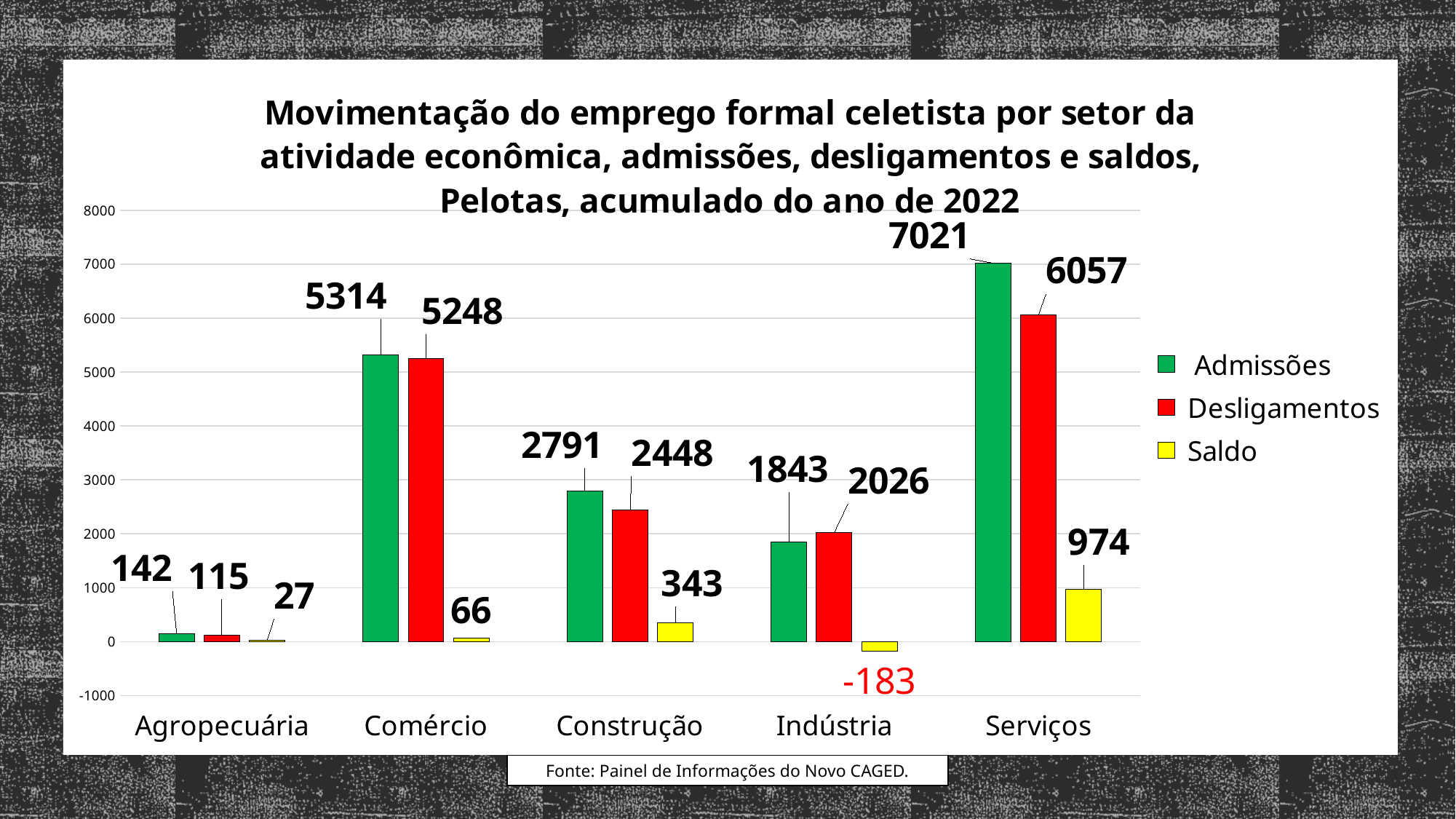
What colour represents the Saldo series in the legend? Yellow Which sector has the lowest Desligamentos value? Agropecuária What is the difference between Admissões and Desligamentos for Construção? 343 What kind of chart is shown on the slide? Bar chart What is the value of Admissões for Serviços? 7021 How many sectors are shown on the x axis? 5 What is the value of Desligamentos for Comércio? 5248 How many series does the legend list? 3 Which sector has the highest Admissões value? Serviços Is the Admissões value for Comércio greater or less than 5000? greater What is the Saldo value for Indústria? -183 Which is larger for Indústria, Admissões or Desligamentos? Desligamentos